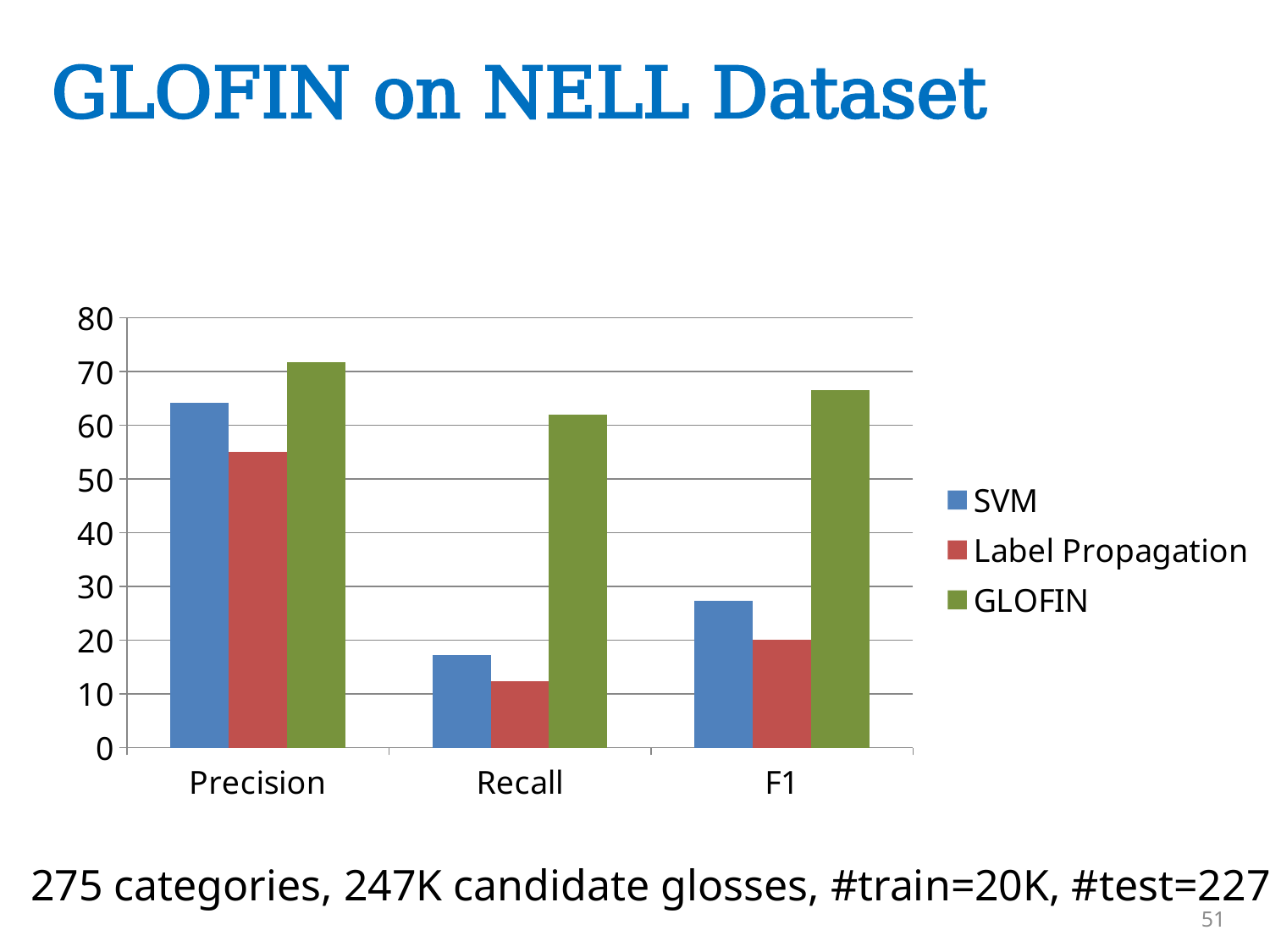
How many series does the legend list? 3 Which series has the highest value for Recall? GLOFIN Which series is shown in green in the legend? GLOFIN Which series has the lowest value for F1? Label Propagation Is the GLOFIN value for Precision greater or less than 70? greater Which is larger: the SVM value for Precision or the SVM value for F1? SVM value for Precision Is the GLOFIN value for Recall greater or less than 60? greater Which is larger: the Label Propagation value for Recall or the Label Propagation value for F1? Label Propagation value for F1 Is the SVM value for Recall greater or less than 20? less How many categories are shown on the x axis? 3 Which series has the lowest value for Precision? Label Propagation What kind of chart is shown on the slide? bar chart